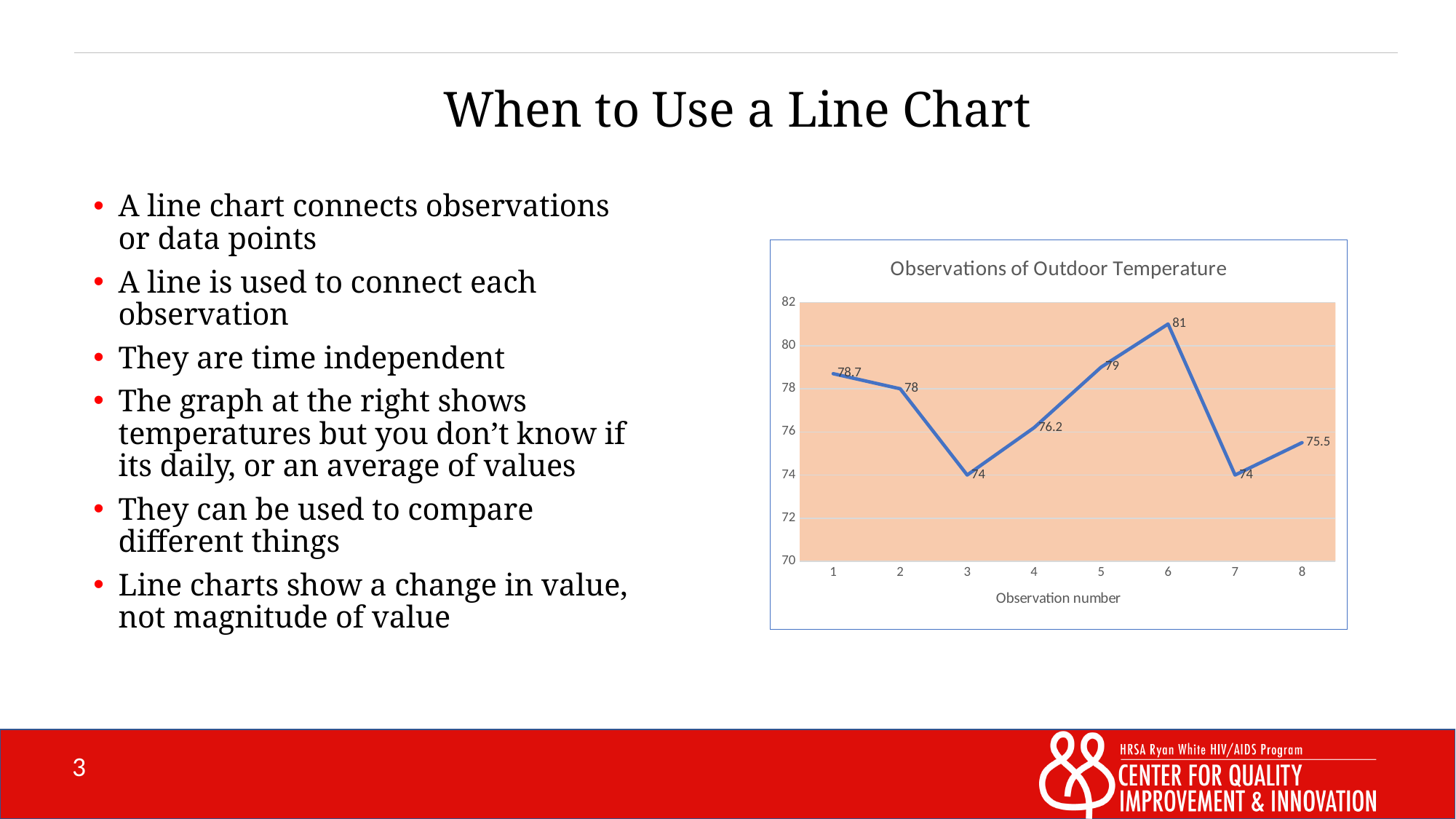
What is the lowest temperature value shown on the chart? 74 What is the temperature value at observation number 8? 75.5 Which observation number has the highest temperature? 6 How many observations are plotted on the chart? 8 What is the temperature value at observation number 4? 76.2 What is the temperature value at observation number 6? 81 Which has a higher temperature value, observation 2 or observation 5? Observation 5 What is the title of the chart? Observations of Outdoor Temperature Does the temperature rise or fall from observation 2 to observation 3? Fall What kind of chart is shown on the slide? Line chart What is the temperature value at observation number 1? 78.7 What is the difference between the temperature at observation 6 and the temperature at observation 7? 7